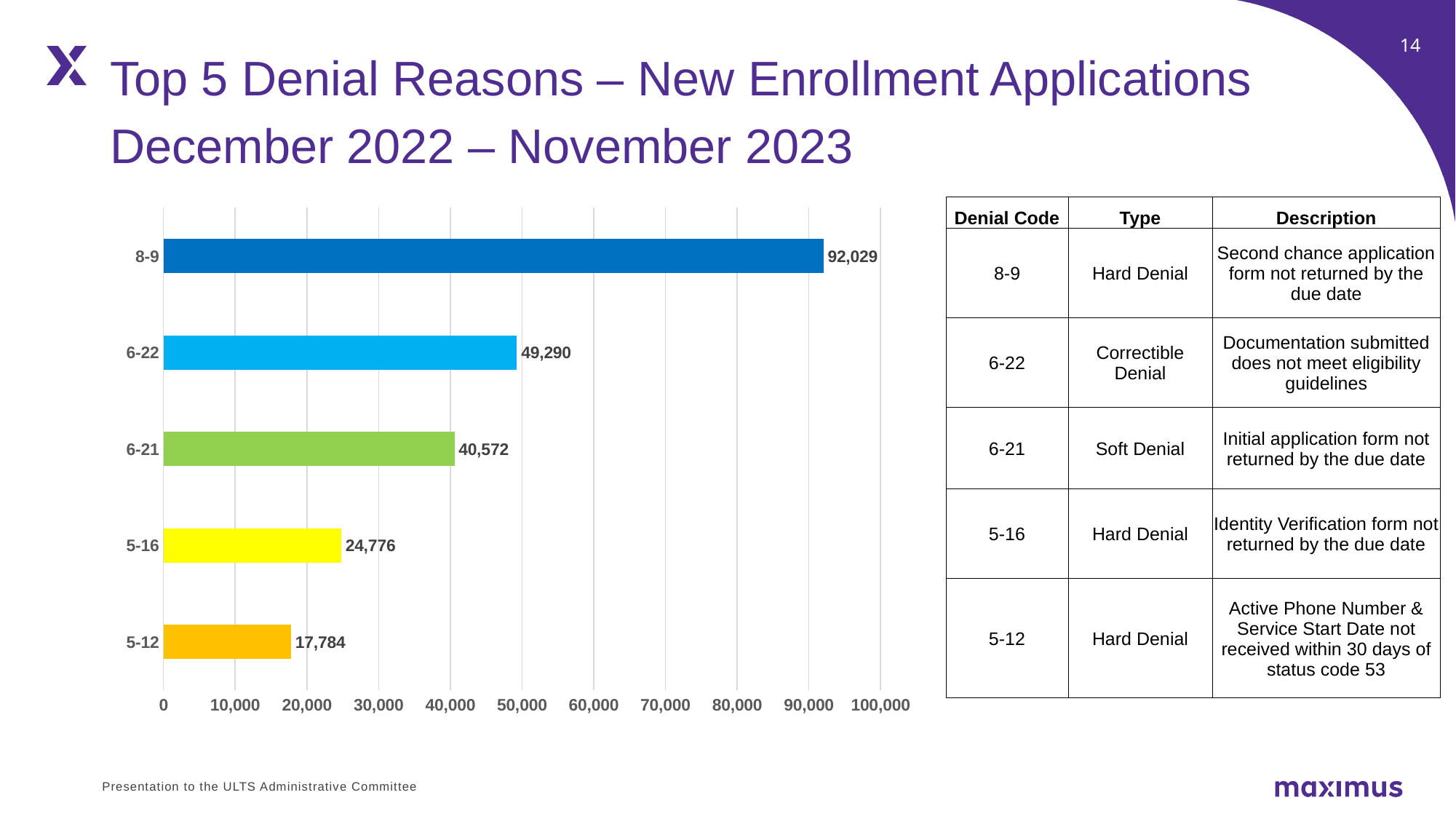
What colour is the bar for denial code 6-21? green Is the value for 6-22 greater or less than 40,000? greater What is the difference between the values for 5-16 and 5-12? 6,992 Which denial code has the highest value? 8-9 Which denial code has the lowest value? 5-12 Which is larger, the value for 6-21 or the value for 5-16? 6-21 What is the difference between the values for 8-9 and 6-22? 42,739 What kind of chart is shown on the slide? bar chart How many denial codes are shown in the chart? 5 What is the value for denial code 8-9? 92,029 What is the value for denial code 6-22? 49,290 What is the value for denial code 5-12? 17,784